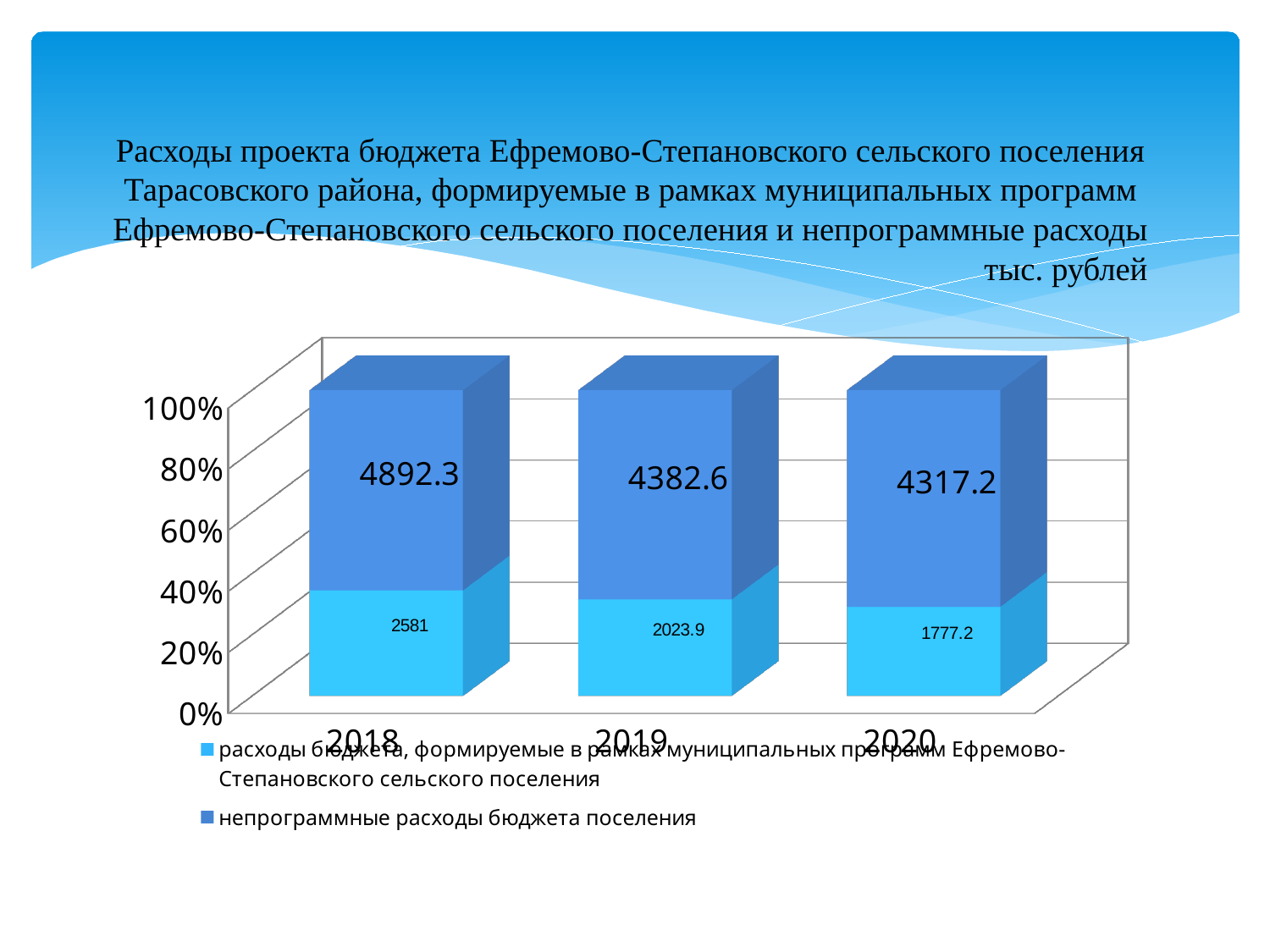
In which year is расходы бюджета, формируемые в рамках муниципальных программ the lowest? 2020 What is the difference between расходы бюджета, формируемые в рамках муниципальных программ in 2018 and in 2019? 557.1 What is the value of расходы бюджета, формируемые в рамках муниципальных программ for 2019? 2023.9 How many years are shown on the x axis? 3 What is the total of the two series for 2020? 6094.4 What is the value of непрограммные расходы бюджета поселения for 2018? 4892.3 Do the values of непрограммные расходы бюджета поселения rise or fall from 2018 to 2020? Fall What is the value of расходы бюджета, формируемые в рамках муниципальных программ for 2020? 1777.2 In which year is непрограммные расходы бюджета поселения the highest? 2018 Which is larger: непрограммные расходы бюджета поселения in 2019 or in 2020? 2019 How many series does the legend list? 2 What kind of chart is shown on the slide? Stacked bar chart